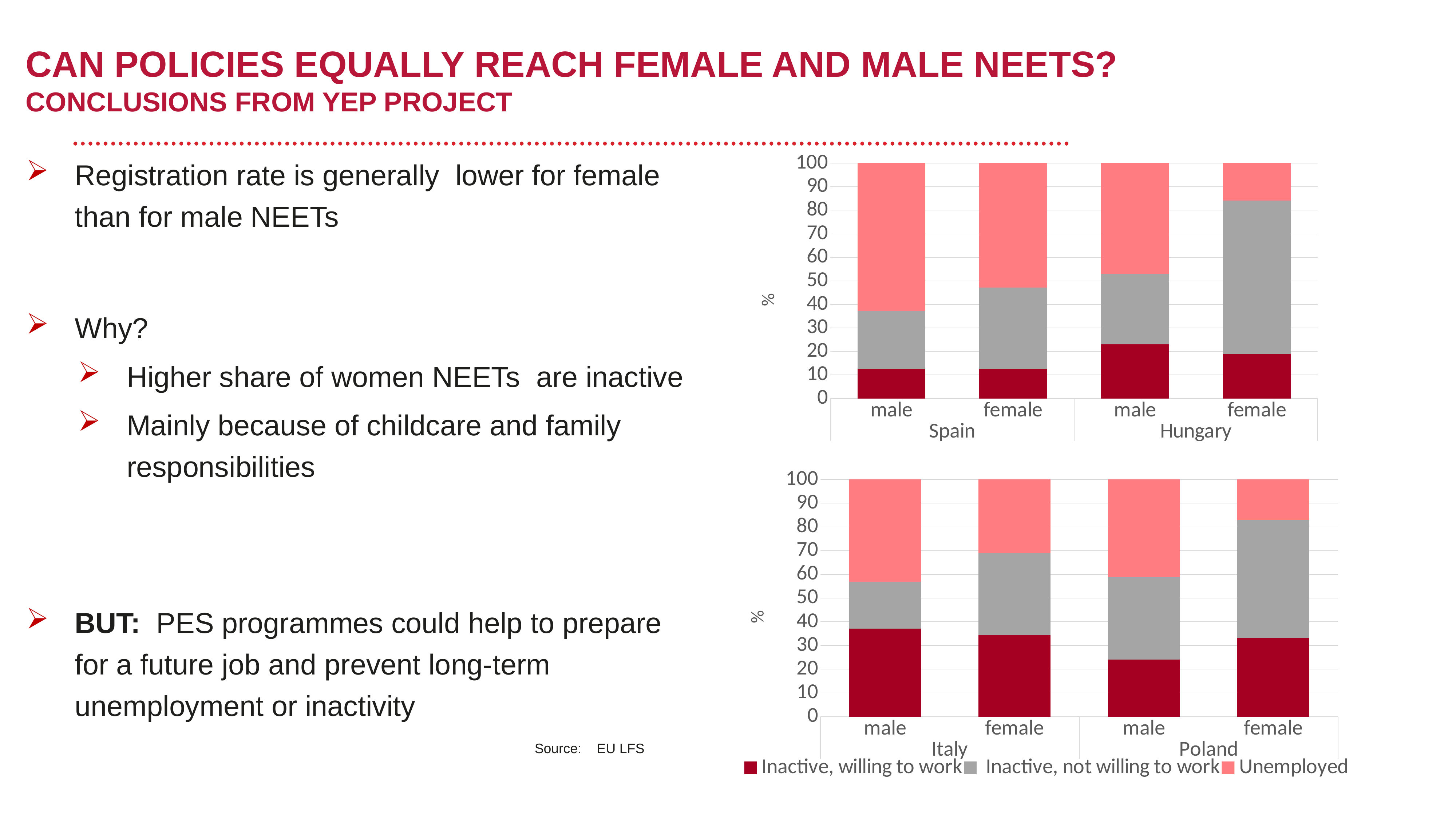
What label is shown on the vertical axis of the charts? % In the bottom chart, which has the larger 'Inactive, willing to work' segment: Italy male or Poland male? Italy male How many series does the legend at the bottom of the slide list? 3 In the bottom chart, is the 'Inactive, willing to work' value for Poland male greater or less than 30? less In the top chart, which has the larger 'Inactive, willing to work' segment: Spain male or Hungary male? Hungary male What kind of chart is the top chart on the slide? stacked bar chart How many bars are plotted in the top chart (Spain and Hungary)? 4 In the bottom chart, is the 'Inactive, willing to work' value for Italy male greater or less than 30? greater In the bottom chart, is the 'Inactive, willing to work' value for Poland female greater or less than 20? greater Which countries are shown in the bottom chart? Italy and Poland In the top chart, which has the larger 'Unemployed' segment: Spain male or Hungary female? Spain male